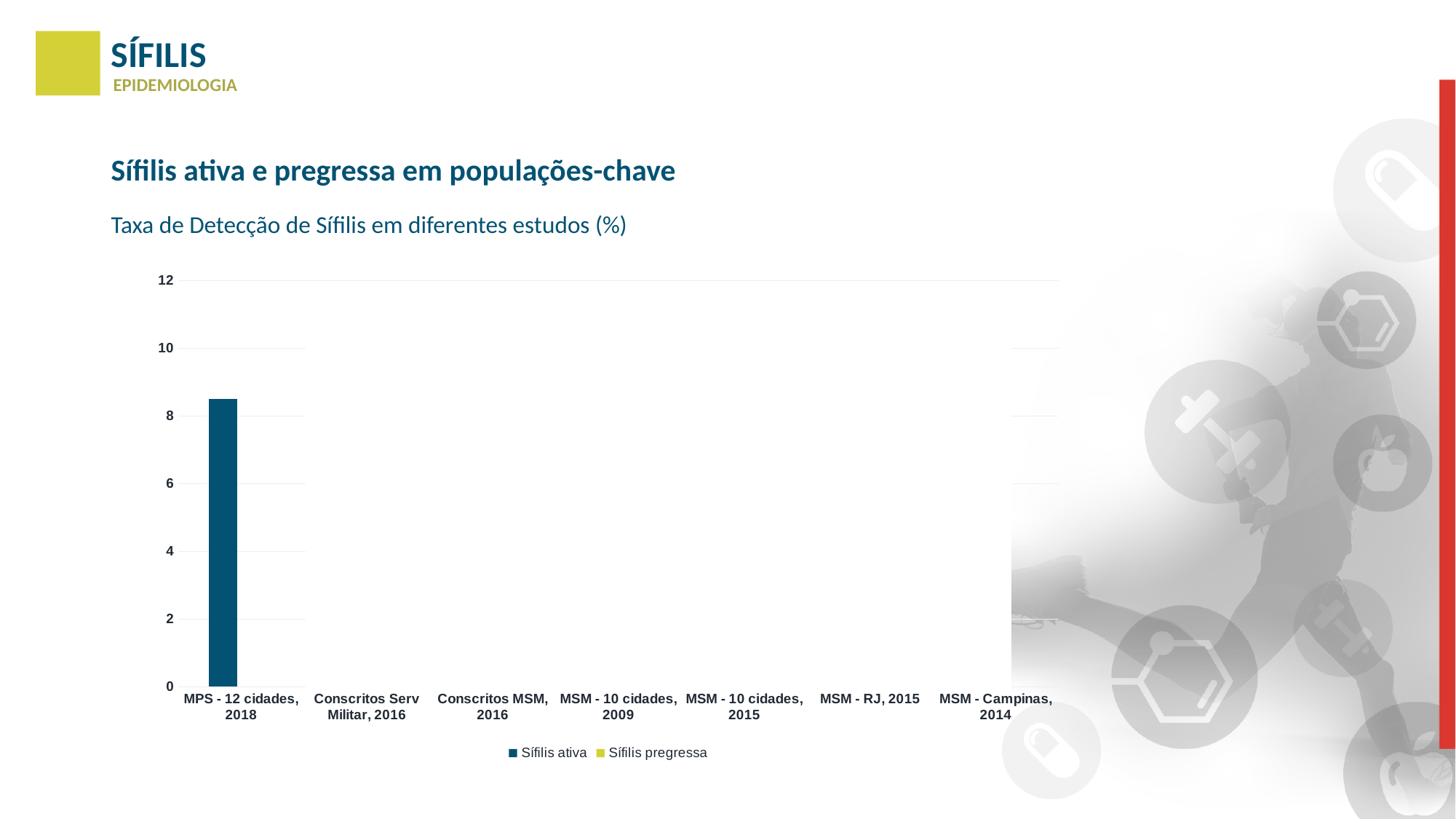
Which category has the tallest bar in the chart? MPS - 12 cidades, 2018 What kind of chart is shown on the slide? Bar chart Is the Sífilis ativa value for MPS - 12 cidades, 2018 greater or less than 8? greater What are the two series named in the chart legend? Sífilis ativa and Sífilis pregressa How many series does the chart legend list? 2 Is the Sífilis ativa value for MPS - 12 cidades, 2018 greater or less than 10? less What is the highest value shown on the y axis of the chart? 12 Is the Sífilis ativa value for MPS - 12 cidades, 2018 greater or less than 6? greater How many categories are listed along the x axis of the chart? 7